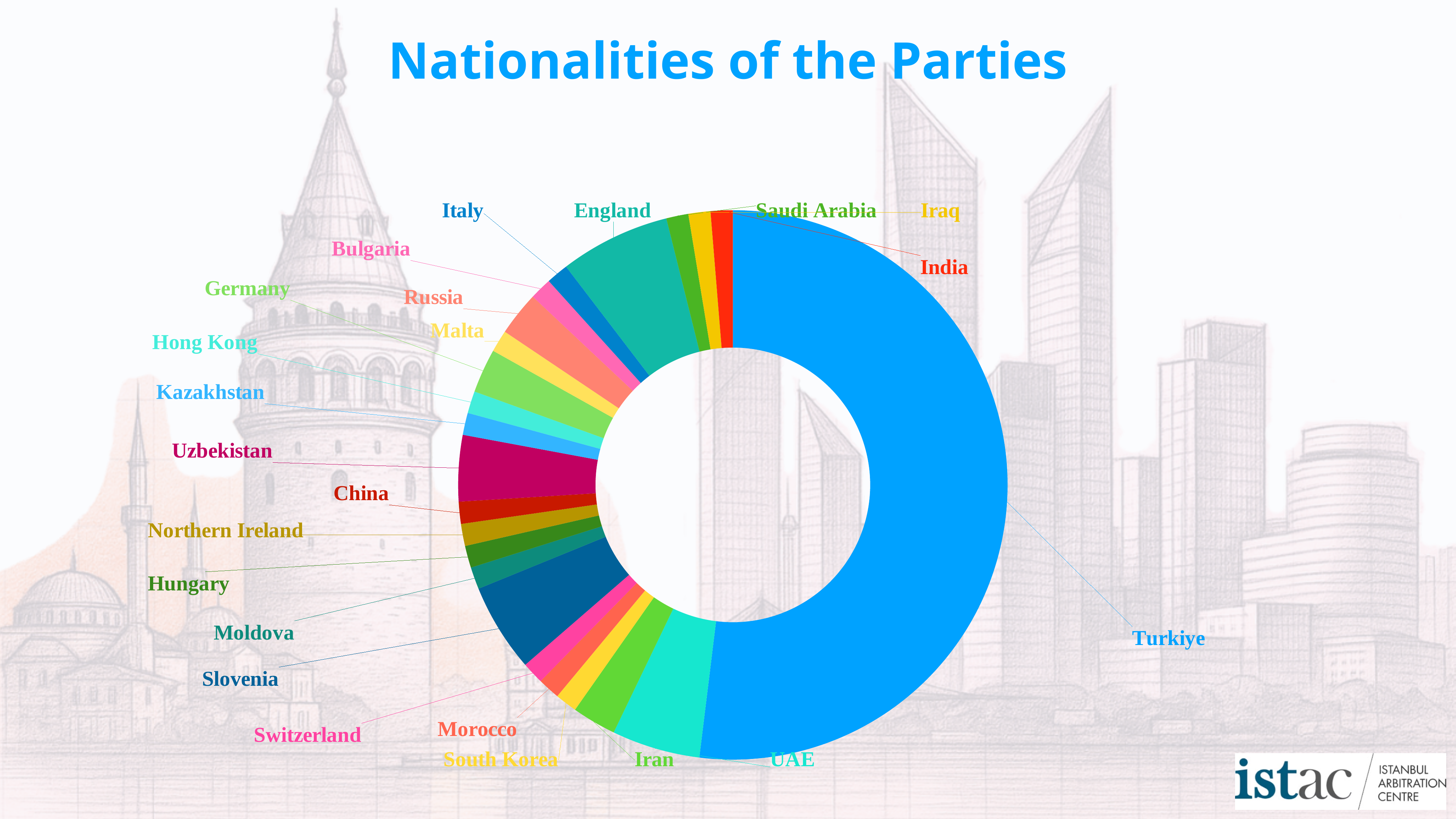
Which slice is larger, Uzbekistan or China? Uzbekistan Which nationality has the largest slice of the chart? Turkiye Which slice is larger, Turkiye or UAE? Turkiye Which slice is larger, UAE or Iran? UAE What is the title of the chart? Nationalities of the Parties What kind of chart is shown on the slide? Pie chart (doughnut) How many nationalities are labelled on the chart? 23 What colour is the Turkiye slice? Blue